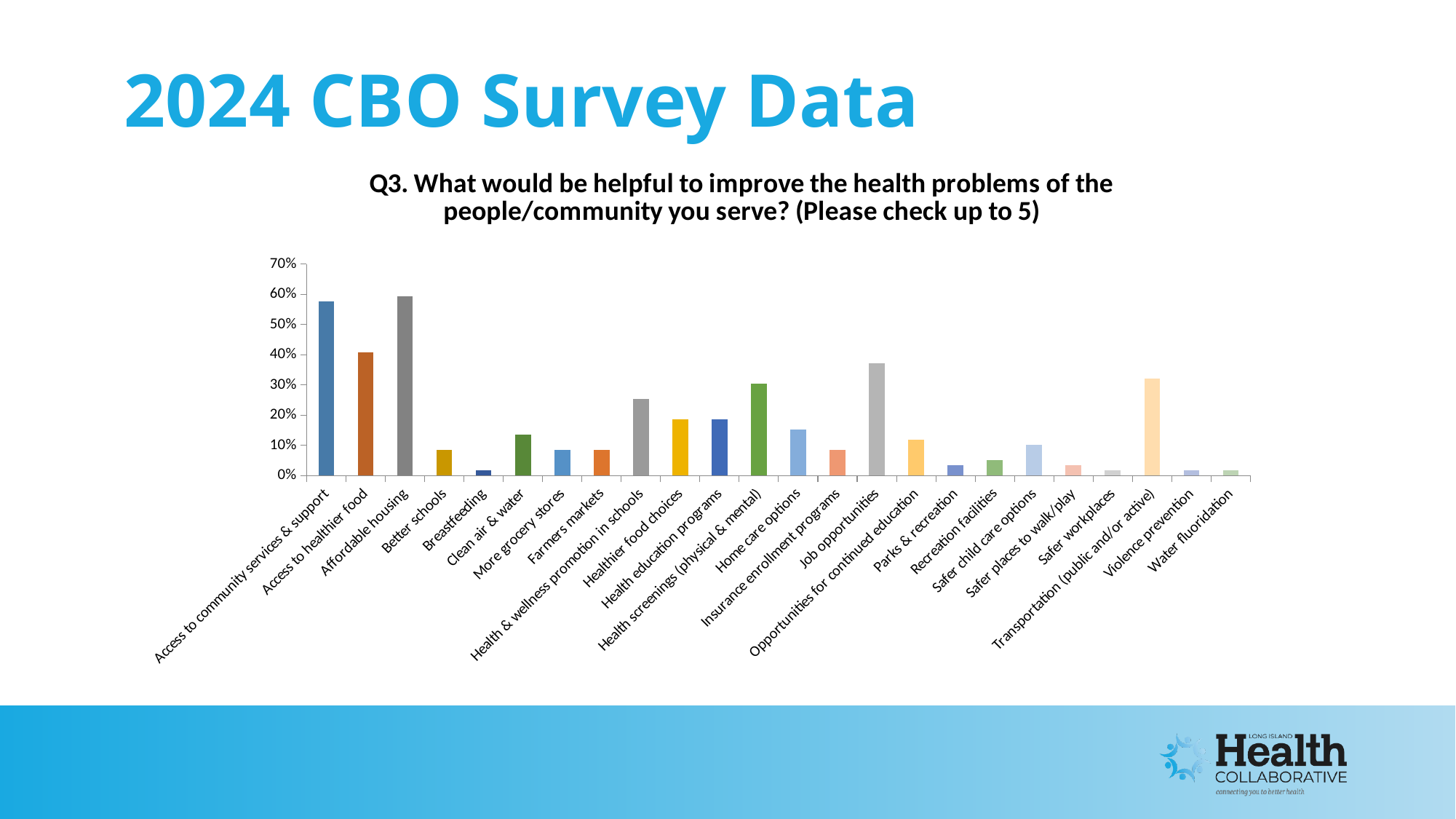
Is the value for Breastfeeding greater or less than 10%? less How many categories are shown on the x axis of the chart? 24 Which is larger, the value for Access to community services & support or the value for Better schools? Access to community services & support Which is larger, the value for Job opportunities or the value for Transportation (public and/or active)? Job opportunities What kind of chart is shown on the slide? bar chart What is the highest value shown on the y axis of the chart? 70% Is the value for Affordable housing greater or less than 50%? greater Is the value for Access to healthier food greater or less than 30%? greater Which is larger, the value for Health screenings (physical & mental) or the value for Home care options? Health screenings (physical & mental)